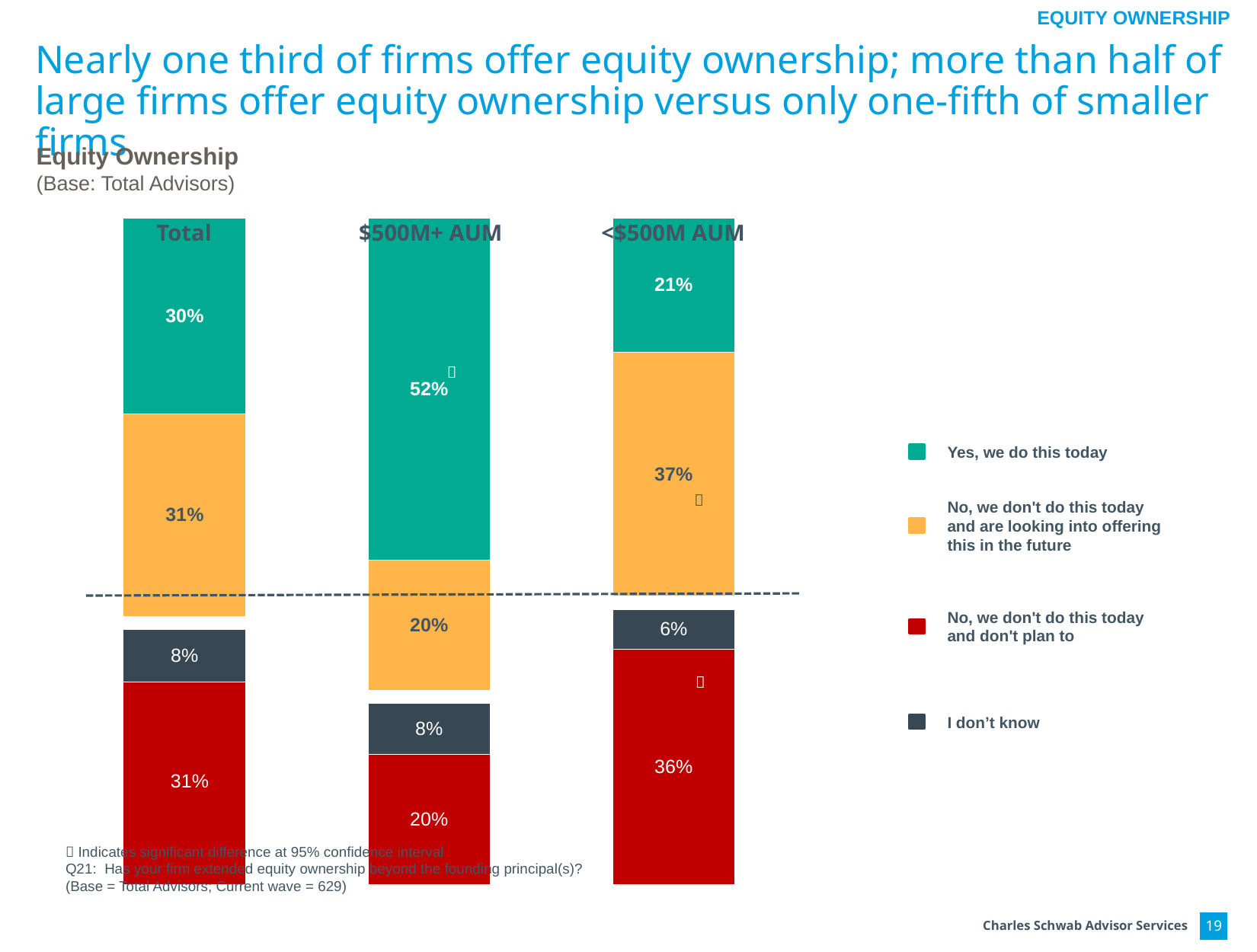
Which colour represents "Yes, we do this today" in the chart? Teal (green) What percentage of <$500M AUM firms say "No, we don't do this today and don't plan to"? 36% Which group has the lowest "I don't know" value? <$500M AUM What is the "I don't know" value for the Total group? 8% How many groups (bars) are shown in the chart? 3 Which is larger: the "No, we don't do this today and don't plan to" value for Total or for $500M+ AUM? Total Which group has the highest share of firms that offer equity ownership today? $500M+ AUM How many response categories does the legend list? 4 What kind of chart is shown on the slide? Stacked bar chart What percentage of $500M+ AUM firms say "Yes, we do this today" for equity ownership? 52% What percentage of <$500M AUM firms are looking into offering equity ownership in the future? 37% What is the difference between the "Yes, we do this today" values for $500M+ AUM and <$500M AUM firms? 31 percentage points